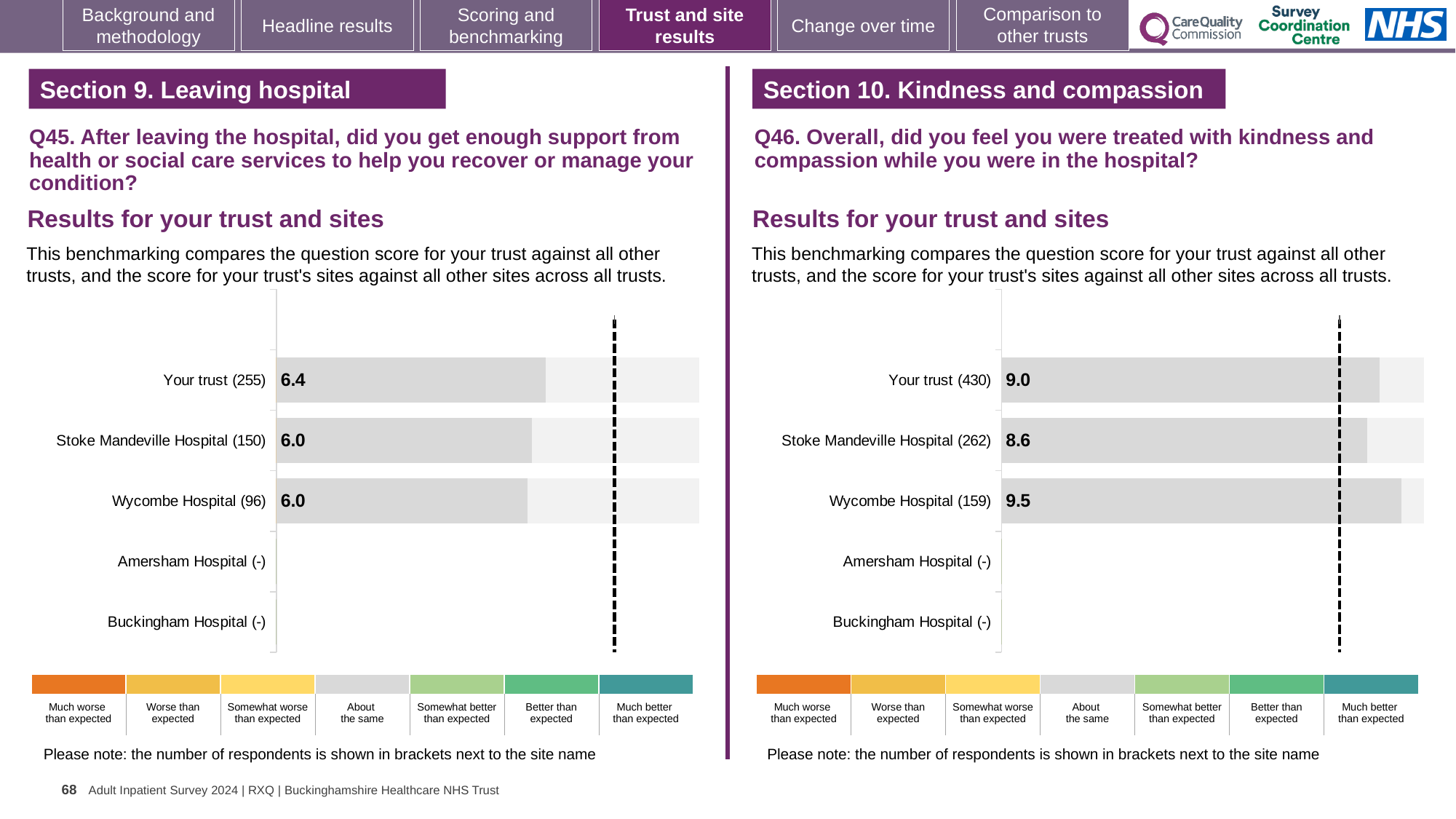
In the Q45 chart on the left, what is the difference between the scores for Your trust and Wycombe Hospital? 0.4 In the Q45 chart on the left, what is the score for Stoke Mandeville Hospital? 6.0 In the Q45 chart on the left, what is the score for Your trust? 6.4 In the Q46 chart on the right, how many respondents are shown in brackets for Your trust? 430 In the Q46 chart on the right, what is the score for Wycombe Hospital? 9.5 In the Q45 chart on the left, which is larger: the score for Your trust or the score for Stoke Mandeville Hospital? Your trust In the Q46 chart on the right, what is the difference between the scores for Wycombe Hospital and Stoke Mandeville Hospital? 0.9 In the Q46 chart on the right, which site or trust row has the highest score? Wycombe Hospital In the Q46 chart on the right, what is the score for Stoke Mandeville Hospital? 8.6 In the Q46 chart on the right, which site or trust row has the lowest score? Stoke Mandeville Hospital What kind of chart is used for the Q45 results on the left? Bar chart In the Q45 chart on the left, how many site or trust rows are listed on the vertical axis? 5